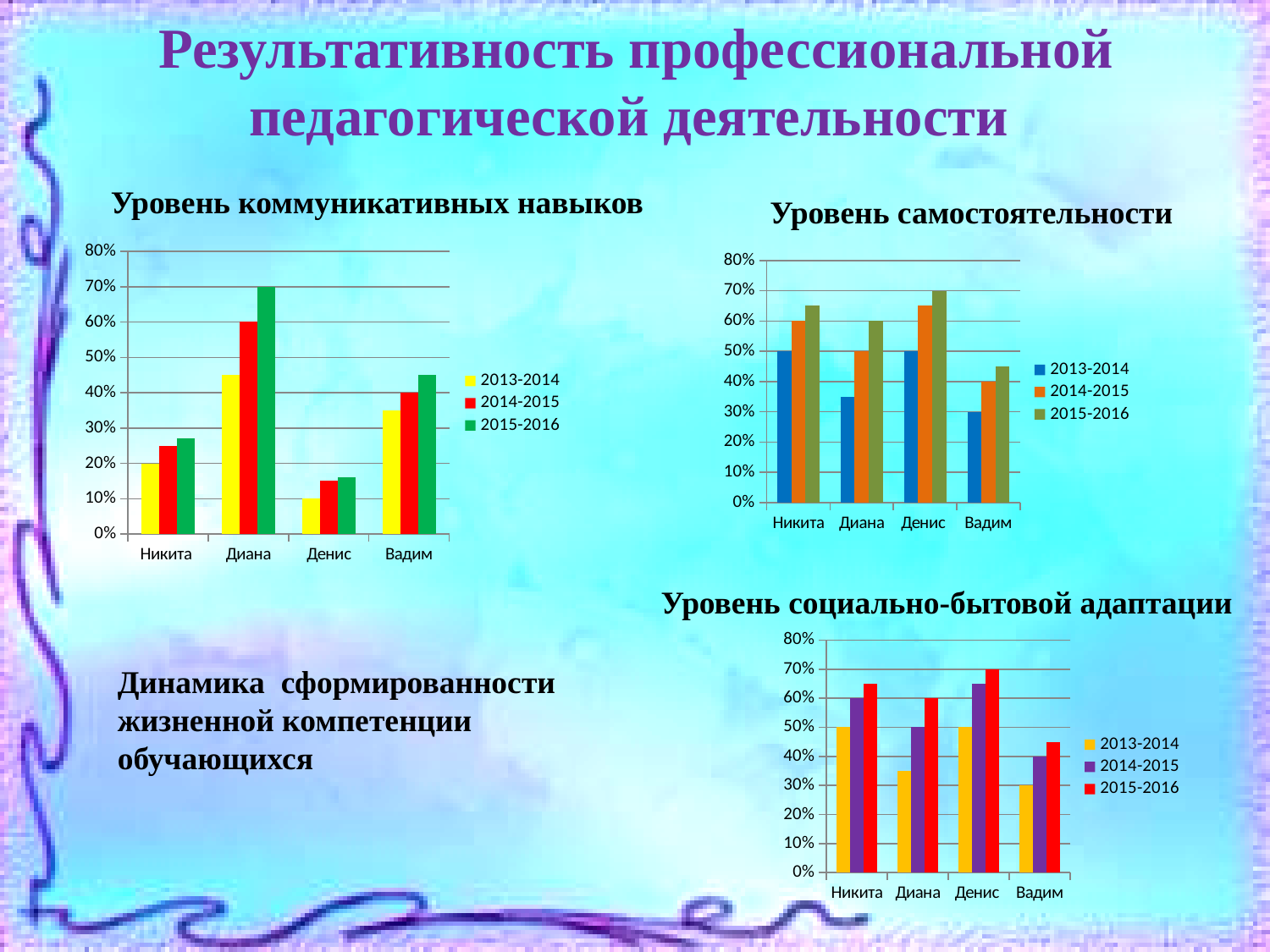
How many series does the legend of 'Уровень коммуникативных навыков' list? 3 In 'Уровень самостоятельности', do the values for Диана rise or fall from 2013-2014 to 2015-2016? rise In 'Уровень коммуникативных навыков', which category has the highest value for 2015-2016? Диана What kind of chart is 'Уровень коммуникативных навыков'? bar chart In 'Уровень коммуникативных навыков', what is the value for Диана in 2015-2016? 70% How many categories are shown on the x axis of 'Уровень коммуникативных навыков'? 4 In 'Уровень социально-бытовой адаптации', which is larger for 2014-2015: Никита or Диана? Никита In 'Уровень коммуникативных навыков', which category has the lowest value for 2013-2014? Денис In 'Уровень коммуникативных навыков', what is the difference between Диана's 2015-2016 and 2014-2015 values? 10% In 'Уровень коммуникативных навыков', what is the value for Денис in 2013-2014? 10% In 'Уровень коммуникативных навыков', is the value for Вадим in 2015-2016 greater or less than 40%? greater In 'Уровень самостоятельности', what is the value for Денис in 2015-2016? 70%